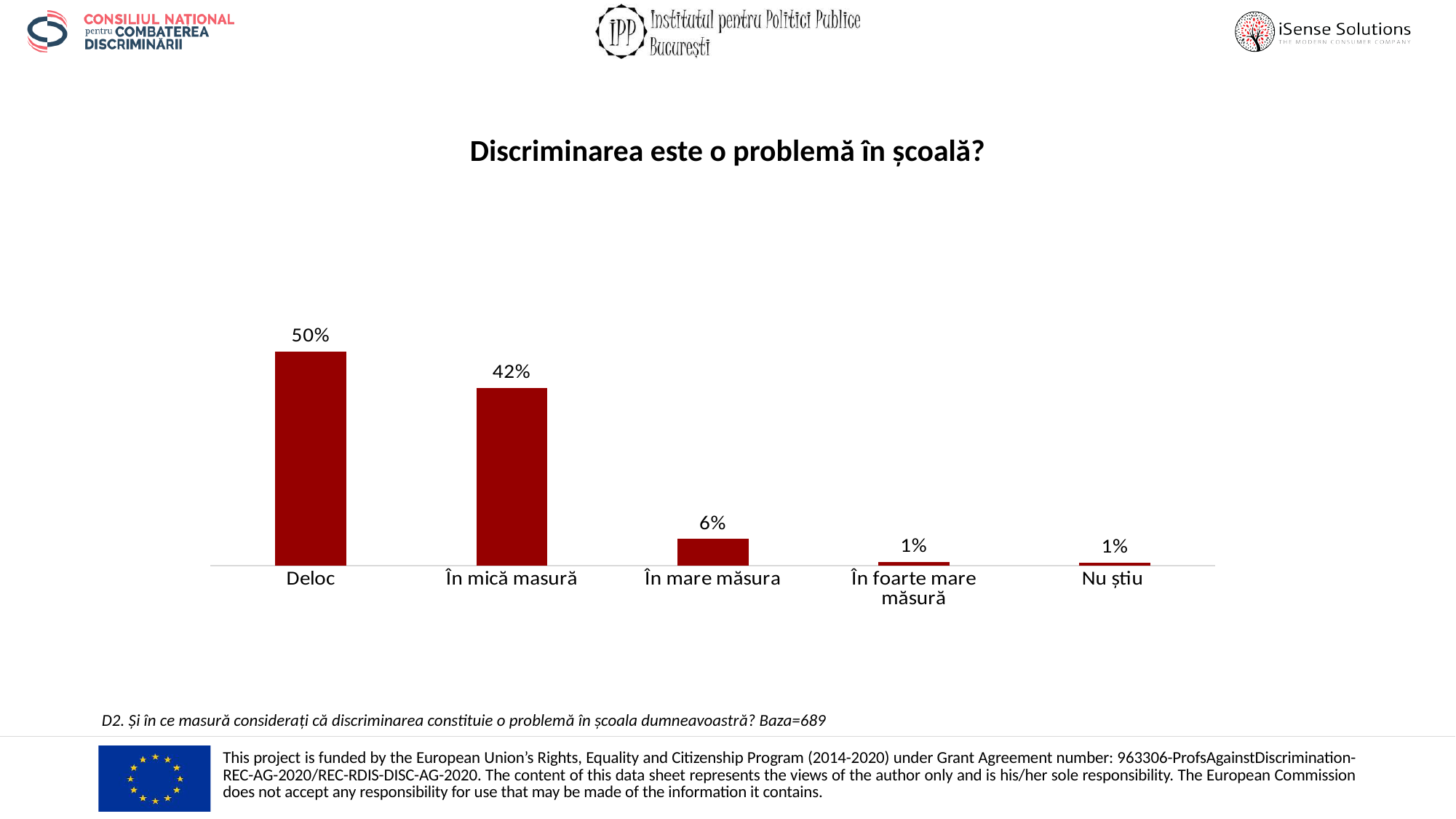
Which category has the highest value? Deloc What is the value for "Deloc"? 50% What is the value for "Nu știu"? 1% What colour are the bars in the chart? Dark red What is the value for "În mică masură"? 42% Which is larger, the value for "În mare măsura" or the value for "Nu știu"? În mare măsura What is the difference between the values for "Deloc" and "În mică masură"? 8% What is the difference between the values for "În mică masură" and "În mare măsura"? 36% What kind of chart is shown on the slide? Bar chart What is the title of the chart? Discriminarea este o problemă în școală? What is the value for "În mare măsura"? 6% How many categories are shown on the chart? 5